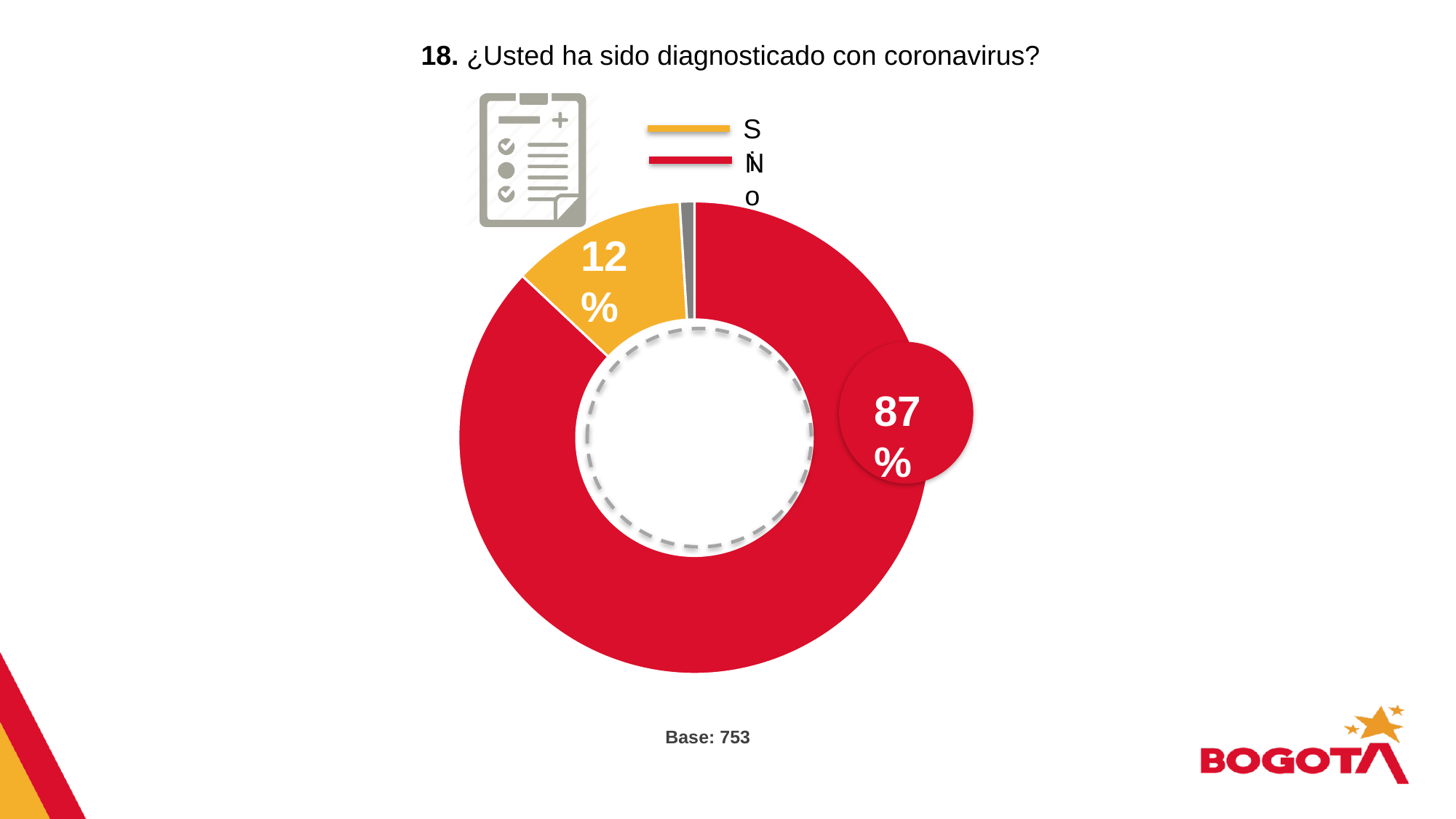
Which of the two labelled responses, "Sí" or "No", has the smaller share? Sí What percentage of respondents answered "Sí"? 12% Is the share for "Sí" greater or less than 25%? less What kind of chart is shown on the slide? Pie (donut) chart How many entries does the chart legend list? 2 Which response has the largest share of the chart? No What is the base (number of respondents) shown below the chart? 753 By how many percentage points does the "No" share exceed the "Sí" share? 75 percentage points What is the question number and text shown as the chart title? 18. ¿Usted ha sido diagnosticado con coronavirus? Is the share for "No" greater or less than 50%? greater What percentage of respondents answered "No" to whether they have been diagnosed with coronavirus? 87%